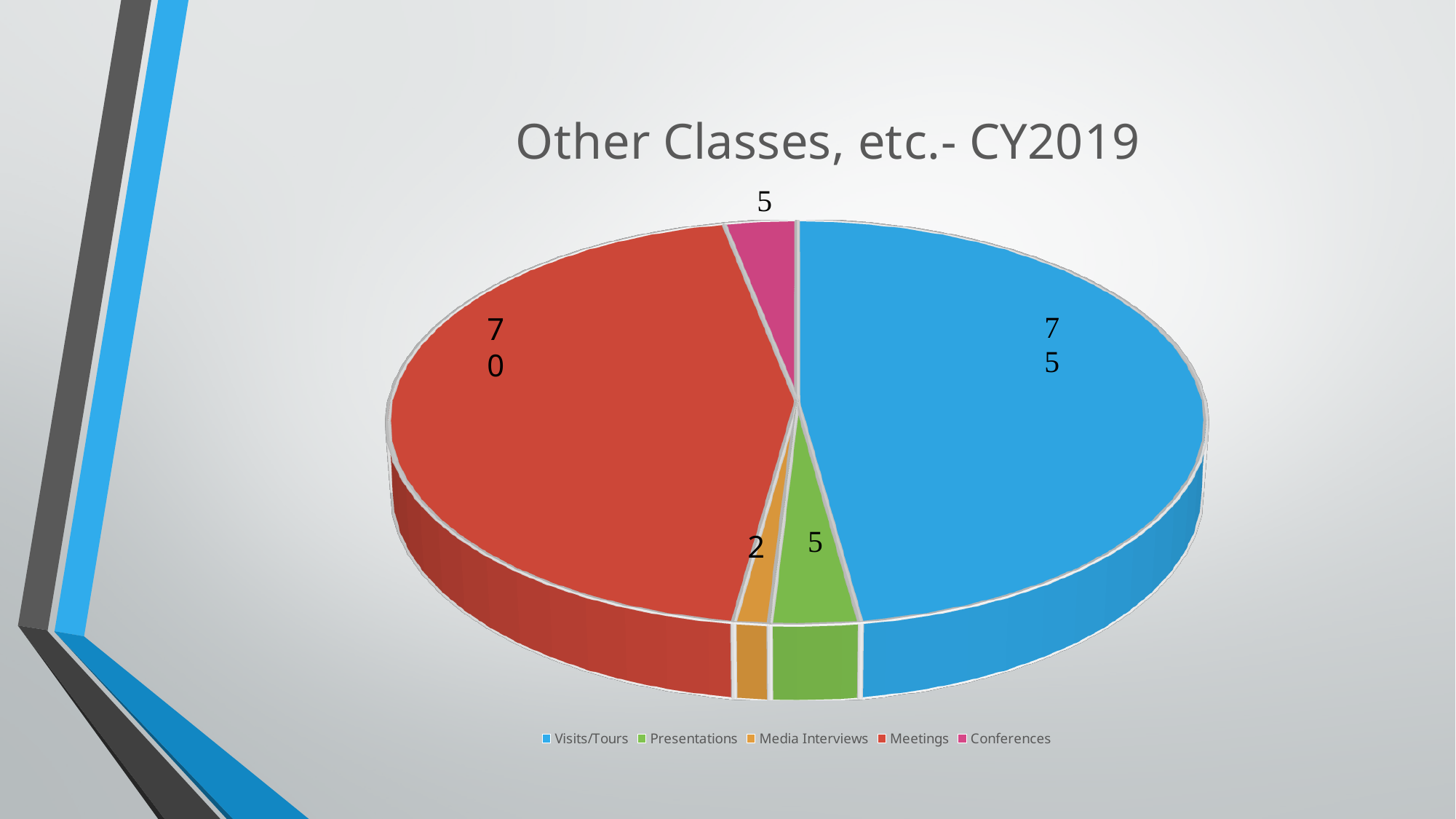
What kind of chart is shown on the slide? Pie chart What is the value for Meetings? 70 Which category has the smallest slice? Media Interviews Which category has the largest slice? Visits/Tours What is the value for Visits/Tours? 75 What is the difference between the values for Visits/Tours and Meetings? 5 What is the total of all the slices in the pie chart? 157 What is the value for Media Interviews? 2 Which is larger, the value for Meetings or the value for Presentations? Meetings What is the title of the chart? Other Classes, etc.- CY2019 What is the value for Presentations? 5 How many categories does the pie chart show? 5